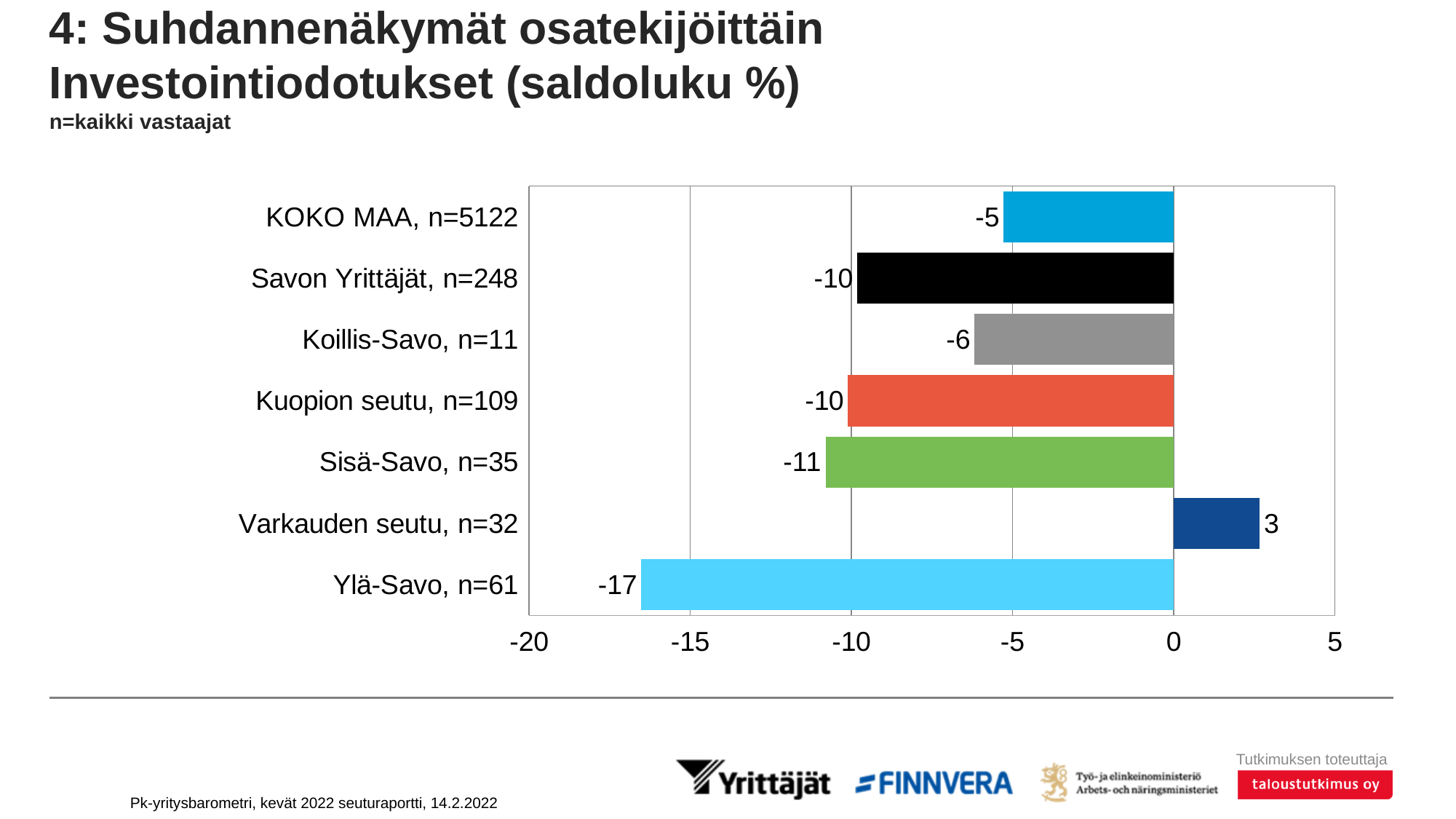
What is the value for Savon Yrittäjät, n=248? -10 Which category has the lowest value? Ylä-Savo, n=61 What colour is the bar for Kuopion seutu, n=109? red What kind of chart is shown on the slide? bar chart Is the value for Ylä-Savo, n=61 greater or less than -15? less How many categories are shown in the chart? 7 What is the value for KOKO MAA, n=5122? -5 What is the difference between the values for Koillis-Savo, n=11 and Sisä-Savo, n=35? 5 What is the value for Varkauden seutu, n=32? 3 Which category has the highest value? Varkauden seutu, n=32 Which has a larger value, Kuopion seutu, n=109 or Koillis-Savo, n=11? Koillis-Savo, n=11 What is the value for Ylä-Savo, n=61? -17